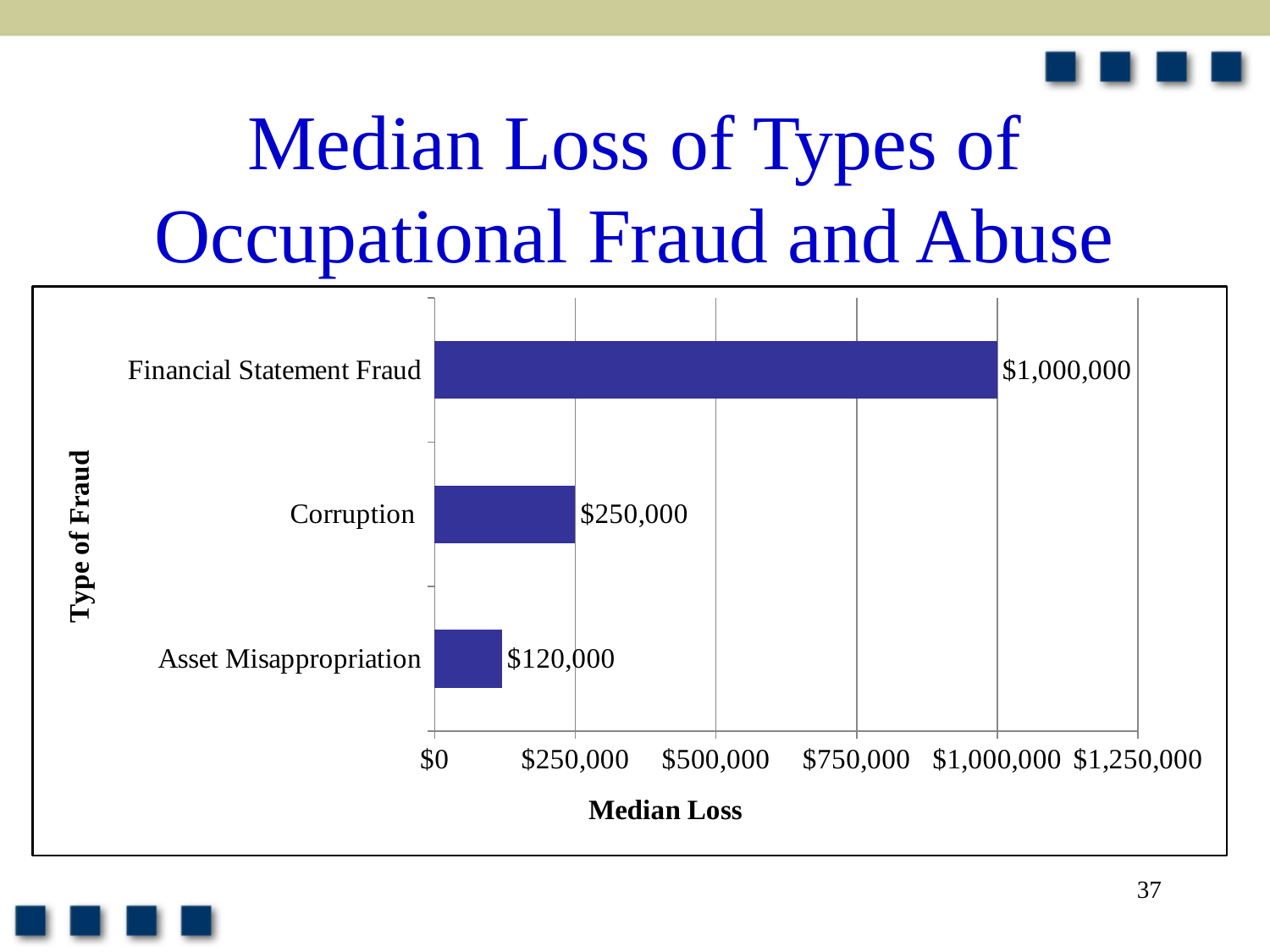
Which has a larger median loss, Corruption or Asset Misappropriation? Corruption What is the median loss for Financial Statement Fraud? $1,000,000 What kind of chart is shown on the slide? bar chart Which type of fraud has the lowest median loss? Asset Misappropriation Which type of fraud has the highest median loss? Financial Statement Fraud What is the difference in median loss between Financial Statement Fraud and Corruption? $750,000 What is the median loss for Asset Misappropriation? $120,000 What is the label of the horizontal axis of the chart? Median Loss How many types of fraud are shown in the chart? 3 What is the difference in median loss between Corruption and Asset Misappropriation? $130,000 Is the median loss for Asset Misappropriation greater or less than $250,000? less What is the median loss for Corruption? $250,000